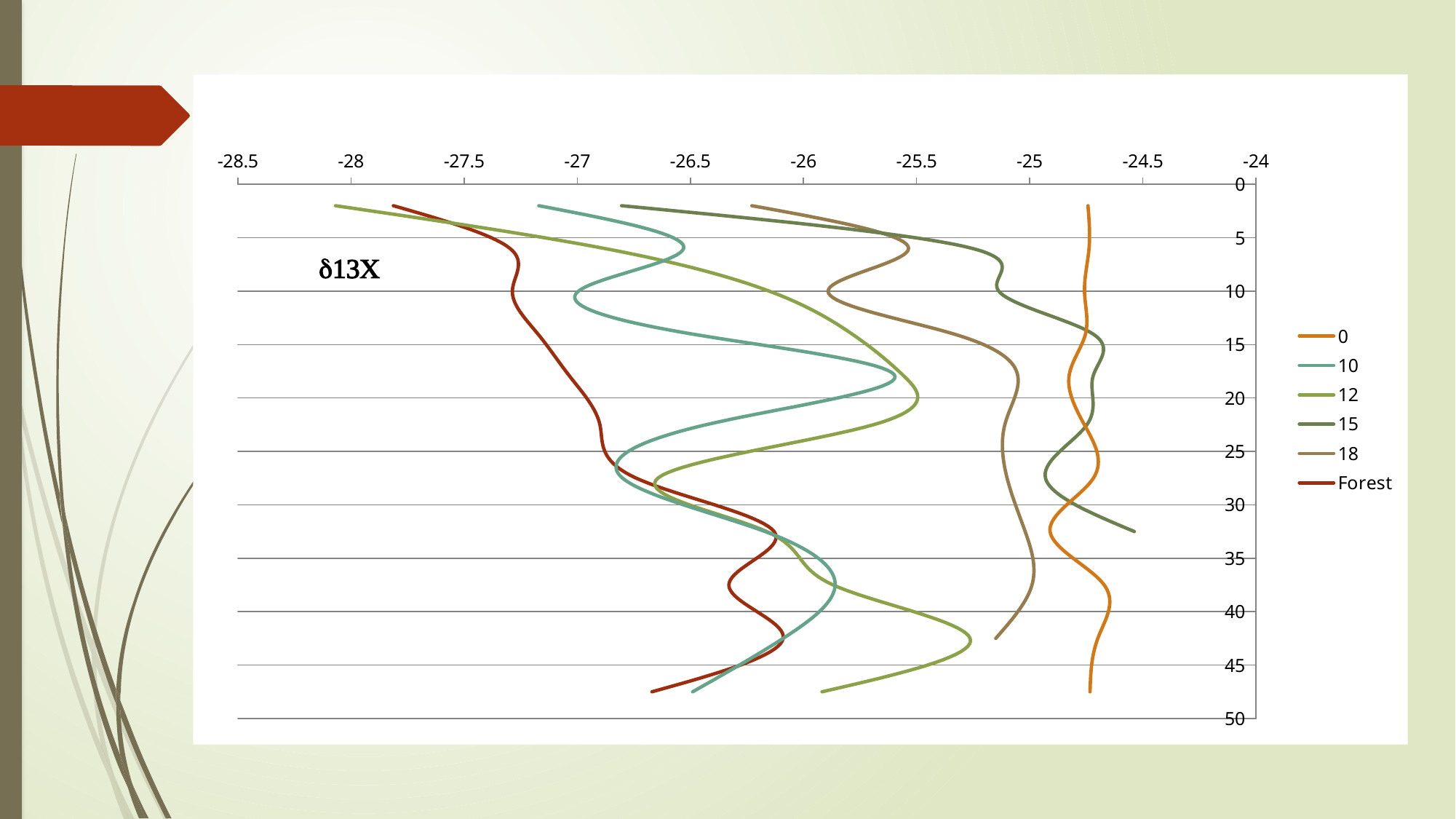
Is the value of the 10 series at depth 18 greater or less than -26? greater Is the value of the 15 series at depth 32 greater or less than -25? greater What label is printed inside the plot area near the upper left? δ13X What kind of chart is shown on the slide? line chart Which series has the lowest (most negative) value at depth 10? Forest Which series is drawn in orange? 0 How many series does the legend list? 6 At depth 40, which series has the higher (less negative) value, 12 or 10? 12 Is the value of the 12 series at depth 2 greater or less than -27.5? less At depth 20, which series has the higher (less negative) value, 0 or Forest? 0